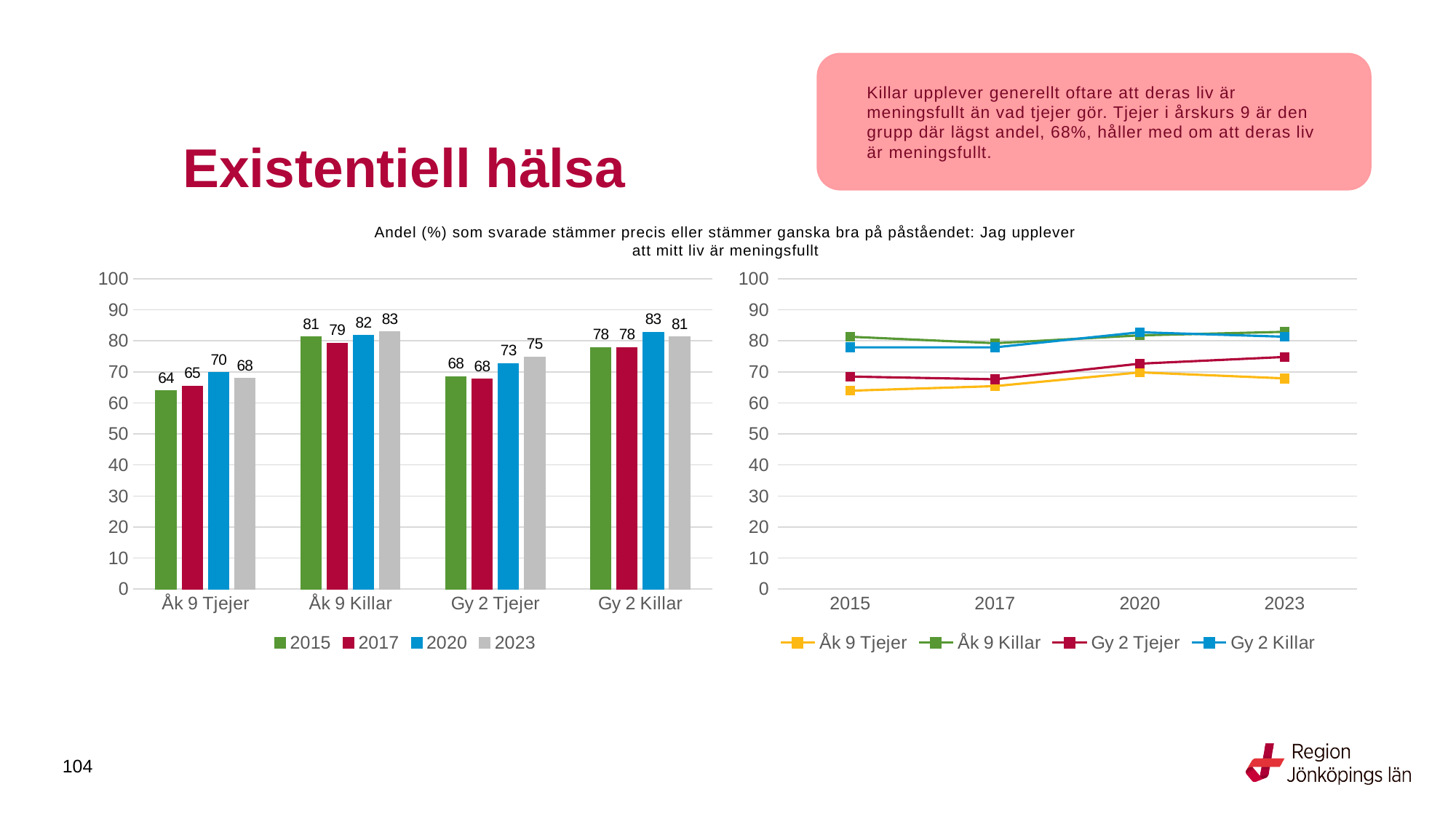
In the left bar chart, which is larger for Åk 9 Killar: the 2017 value or the 2020 value? 2020 In the left bar chart, what is the value for Gy 2 Tjejer in 2023? 75 In the right line chart, does the Gy 2 Tjejer line rise or fall from 2015 to 2023? rise In the left bar chart, which category has the highest value for 2023? Åk 9 Killar In the right line chart, is the value for Åk 9 Tjejer in 2015 greater or less than 70? less In the left bar chart, what is the value for Åk 9 Tjejer in 2015? 64 How many series does the legend of the left bar chart list? 4 In the left bar chart, what is the value for Gy 2 Killar in 2020? 83 How many categories are shown on the x axis of the left bar chart? 4 In the left bar chart, what is the difference between the 2023 and 2015 values for Gy 2 Tjejer? 7 What kind of chart is the chart on the right of the slide? line chart In the left bar chart, which category has the lowest value for 2015? Åk 9 Tjejer